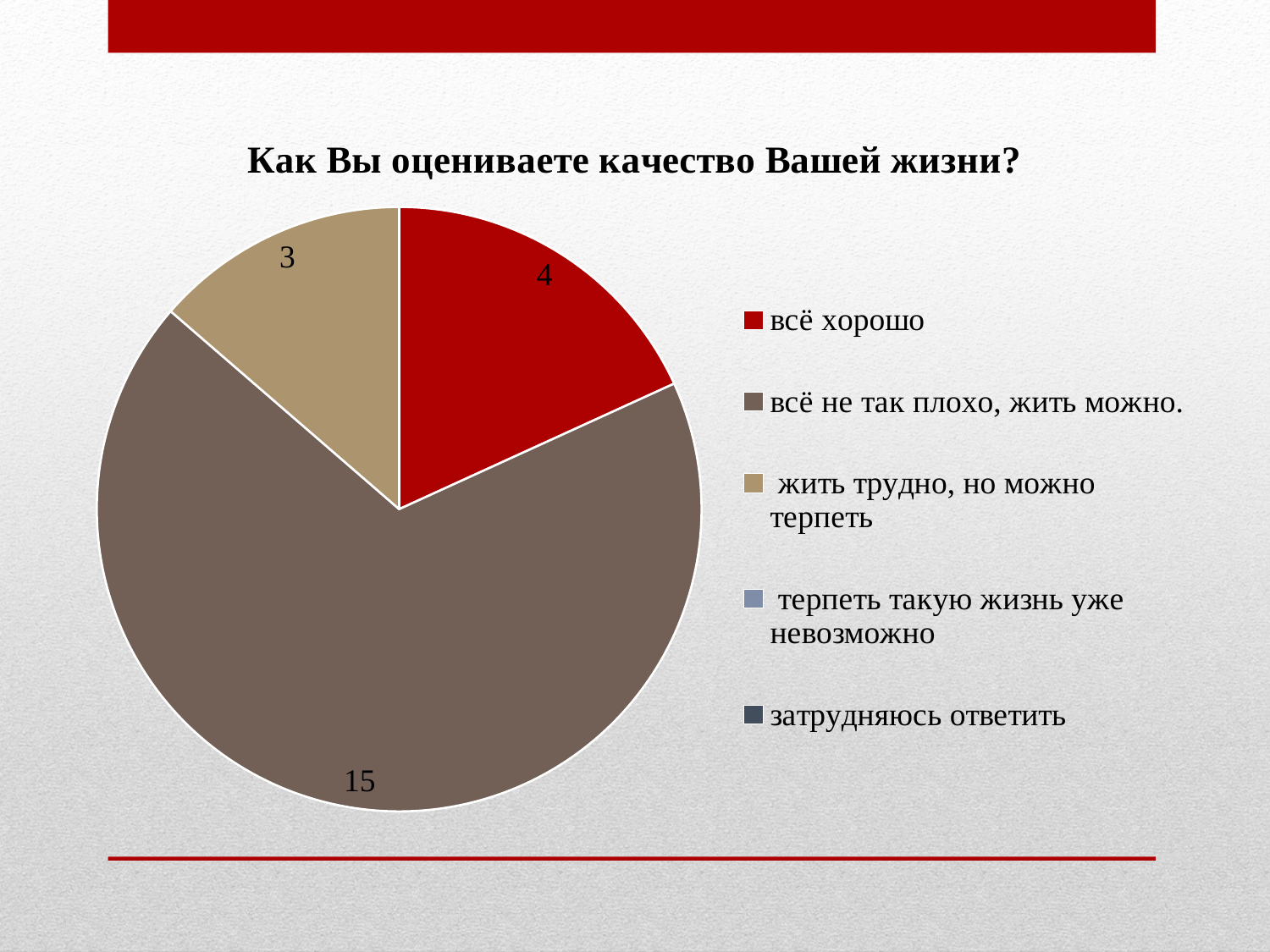
What is the title of the chart? Как Вы оцениваете качество Вашей жизни? What is the value for the slice "всё хорошо"? 4 What is the value for the slice "жить трудно, но можно терпеть"? 3 How many slices with data labels are visible in the pie chart? 3 What is the difference between the values for "всё хорошо" and "жить трудно, но можно терпеть"? 1 Which category has the largest slice of the pie? всё не так плохо, жить можно. How many entries does the legend list? 5 Which is larger: the value for "всё хорошо" or the value for "жить трудно, но можно терпеть"? всё хорошо Which labelled slice has the smallest value? жить трудно, но можно терпеть What is the value for the slice "всё не так плохо, жить можно."? 15 What is the difference between the values for "всё не так плохо, жить можно." and "всё хорошо"? 11 What type of chart is shown on the slide? pie chart